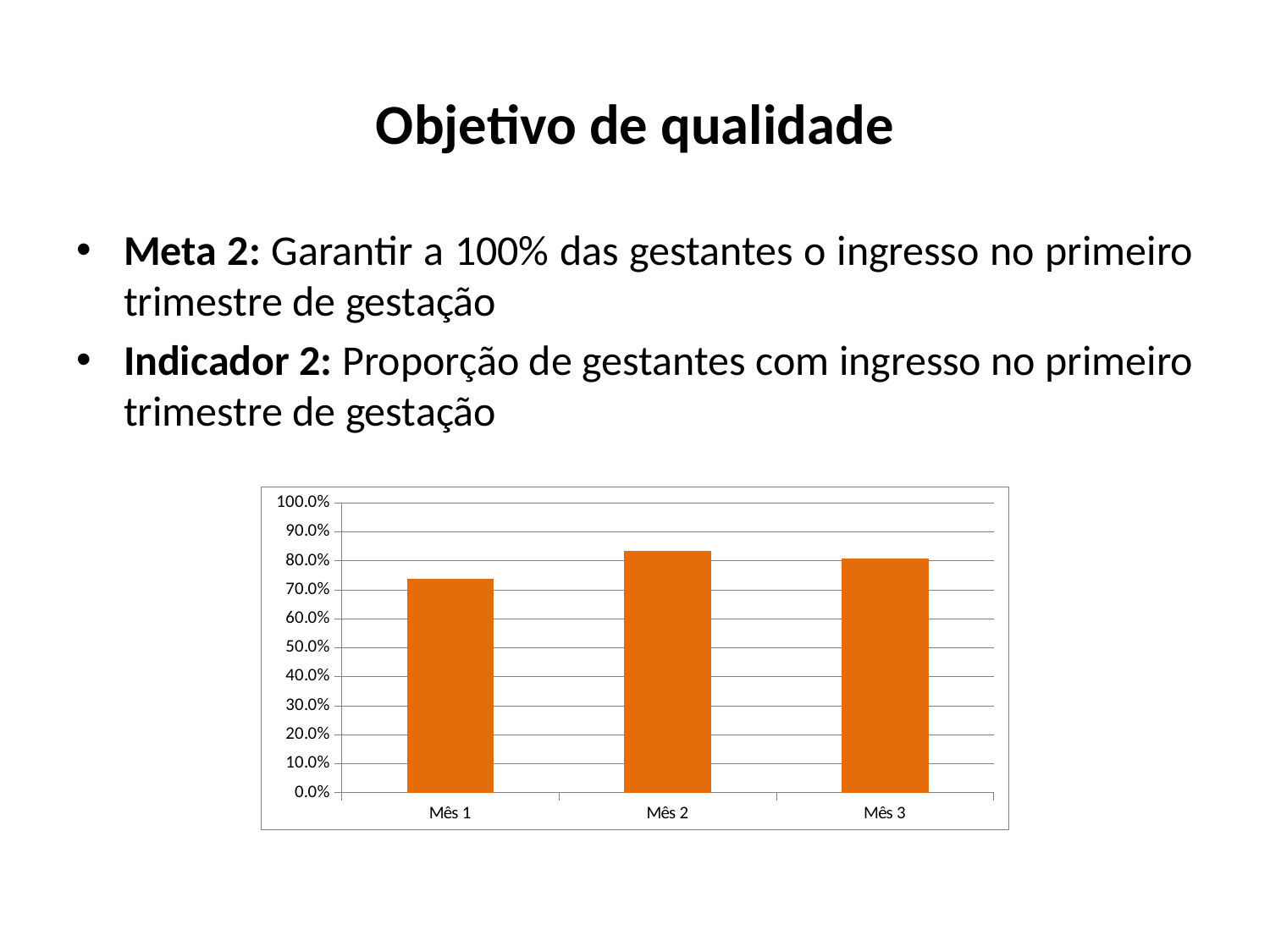
Is the value for Mês 1 greater or less than 80%? less Which category has the lowest value in the chart? Mês 1 Is the value for Mês 3 greater or less than 90%? less What colour are the bars in the chart? orange Is the value for Mês 1 greater or less than 70%? greater Which is larger, the value for Mês 1 or the value for Mês 2? Mês 2 How many categories are plotted on the x axis of the chart? 3 Does the value rise or fall from Mês 1 to Mês 2? rise What kind of chart is shown on the slide? bar chart Which is larger, the value for Mês 1 or the value for Mês 3? Mês 3